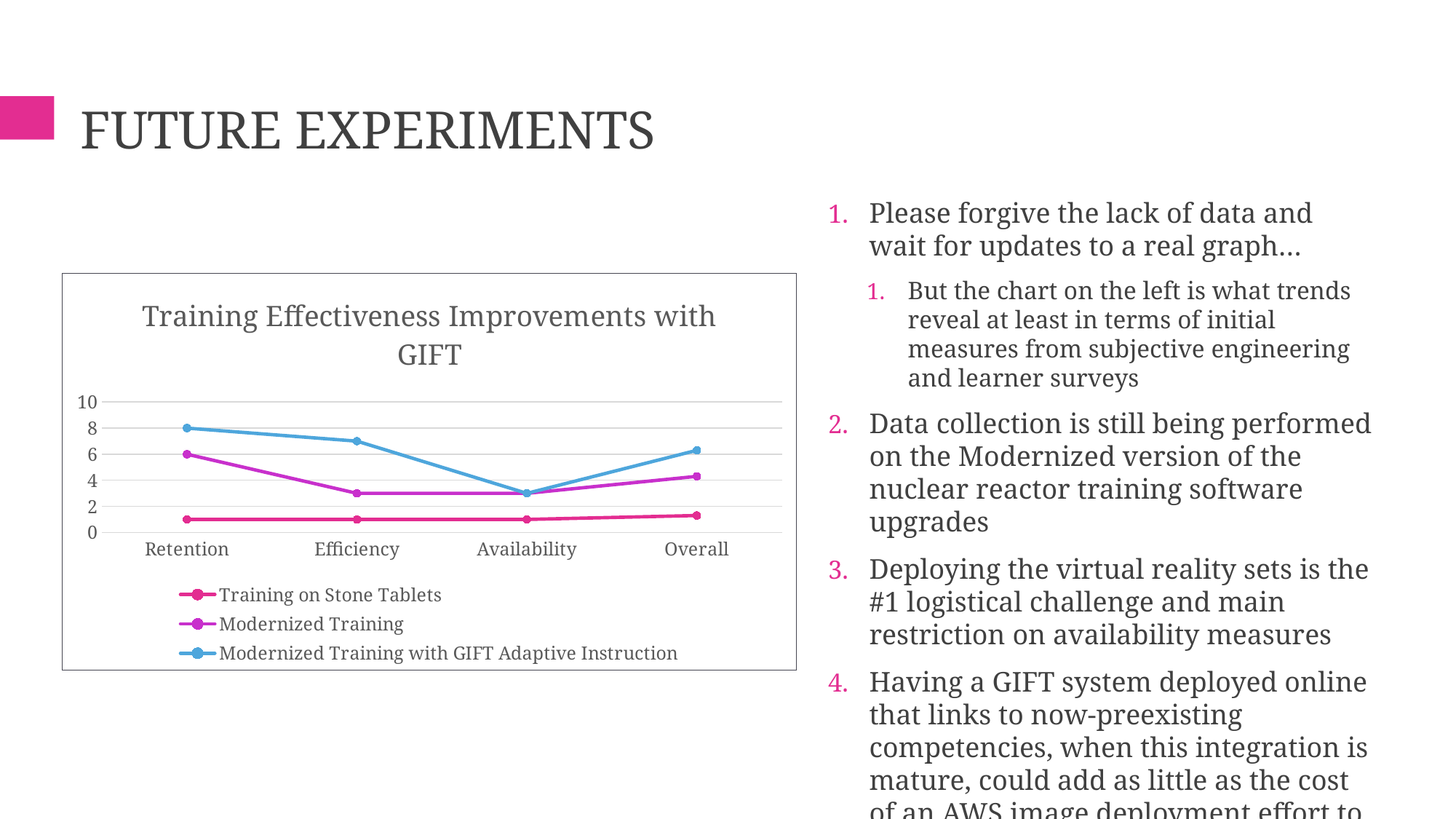
What is the title of the chart? Training Effectiveness Improvements with GIFT Is the value for Training on Stone Tablets at Availability greater or less than 2? less How many categories are shown on the x axis of the chart? 4 Which series has the lowest value at Overall? Training on Stone Tablets How many series does the chart legend list? 3 What kind of chart is shown on the slide? line chart Is the value for Modernized Training at Efficiency greater or less than 4? less